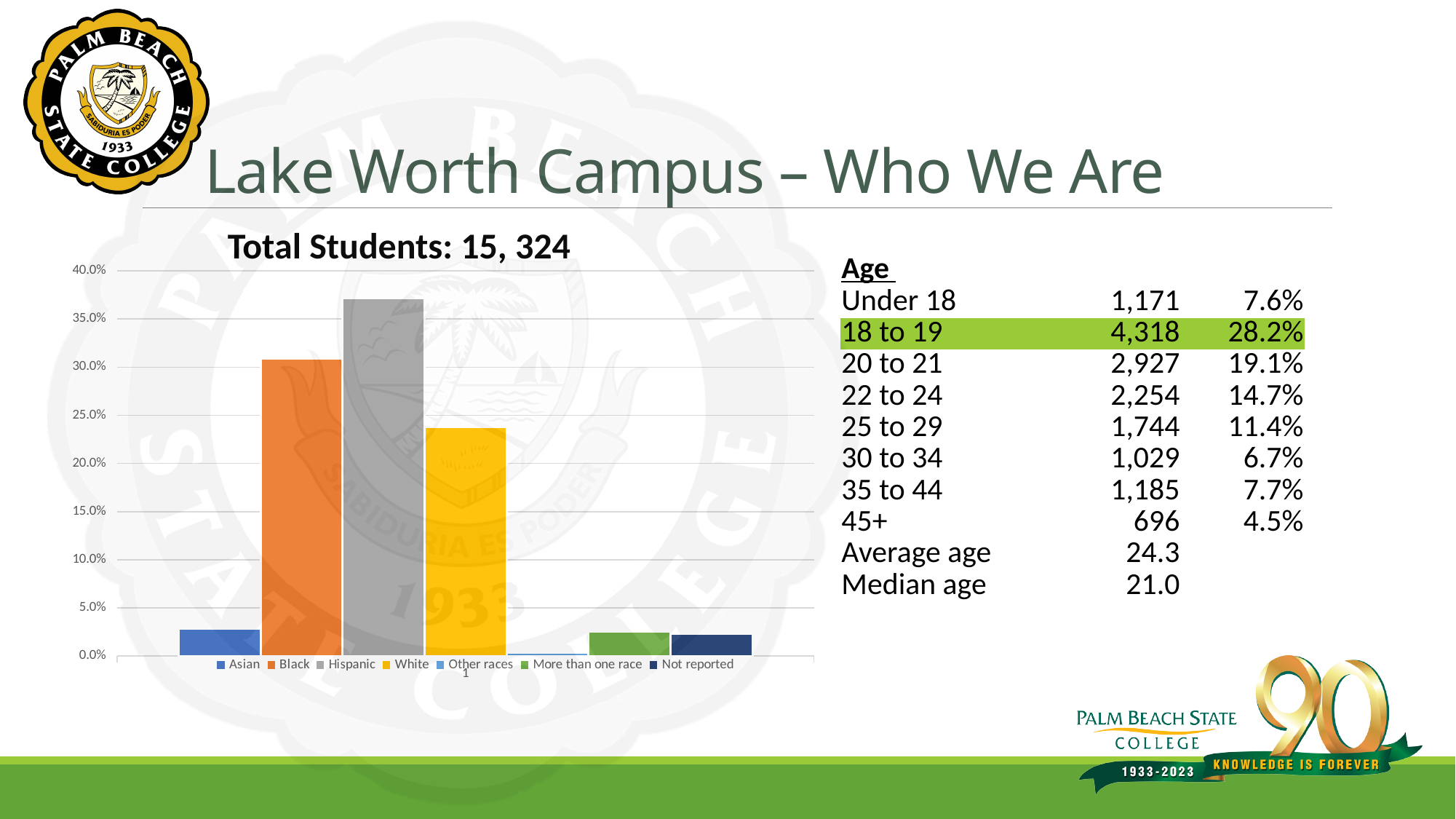
How many entries does the legend of the bar chart list? 7 How many categories does the bar chart show? 7 Which category has the lowest bar in the chart? Other races Which is larger in the chart, the value for Black or the value for White? Black Is the value for White greater or less than 25.0%? less What is the title shown above the bar chart? Total Students: 15, 324 What kind of chart is shown on the slide? bar chart Is the value for Hispanic greater or less than 35.0%? greater Is the value for Black greater or less than 25.0%? greater Which is larger in the chart, the value for Hispanic or the value for Black? Hispanic Which category has the highest bar in the chart? Hispanic